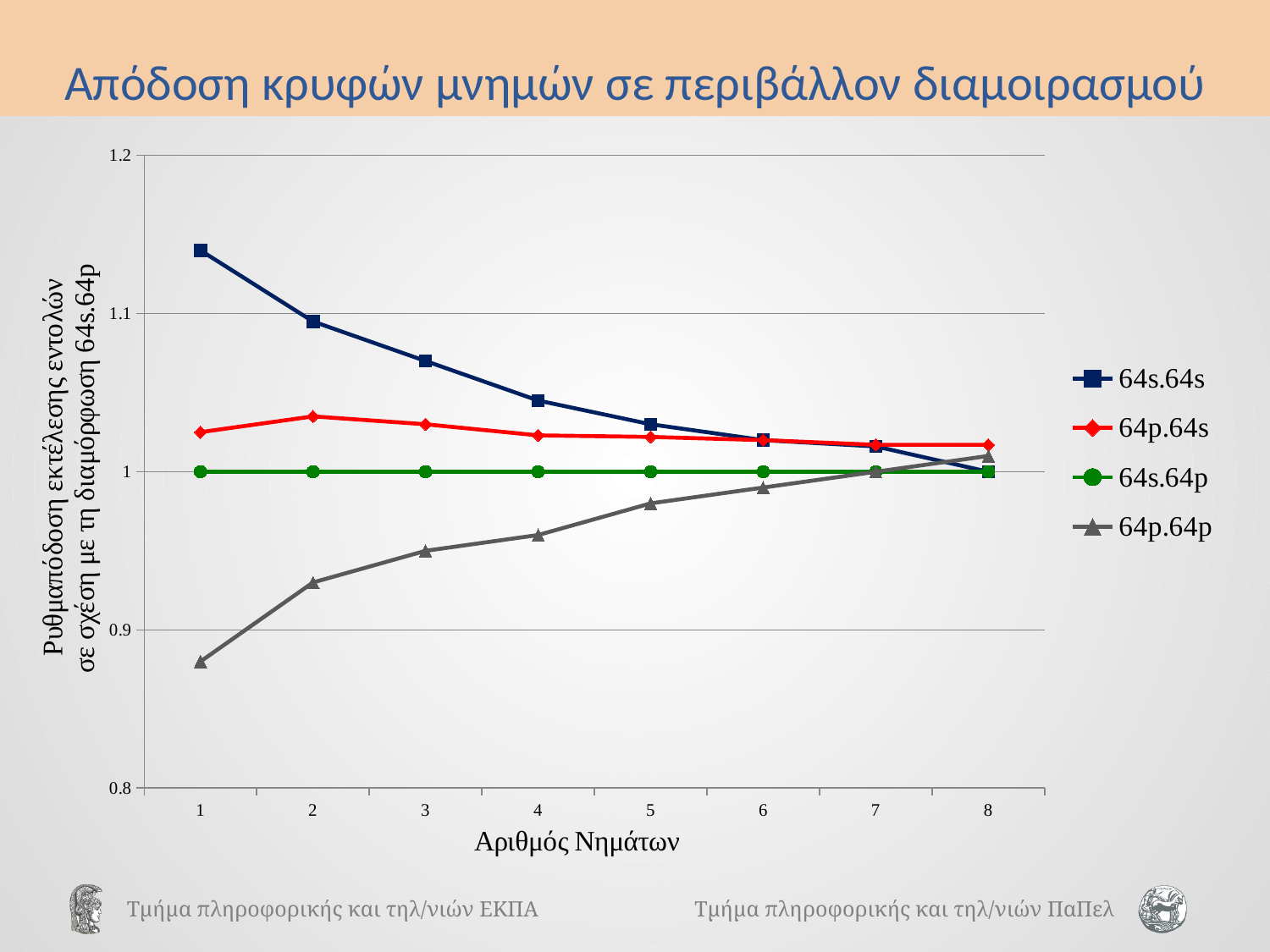
Is the value for 64p.64p at 5 threads greater or less than 1? less Is the value for 64s.64s at 1 thread greater or less than 1.1? greater Which series has the lowest value at 1 thread? 64p.64p At 2 threads, which is larger: 64s.64s or 64p.64s? 64s.64s What kind of chart is shown on the slide? line chart What is the value of the 64s.64p series at 4 threads? 1 How many series does the legend list? 4 Does the 64p.64p series rise or fall as the number of threads increases? rise Which series has the highest value at 1 thread? 64s.64s How many thread counts (x-axis points) are plotted? 8 Does the 64s.64s series rise or fall as the number of threads increases? fall Is the value for 64p.64p at 1 thread greater or less than 0.9? less